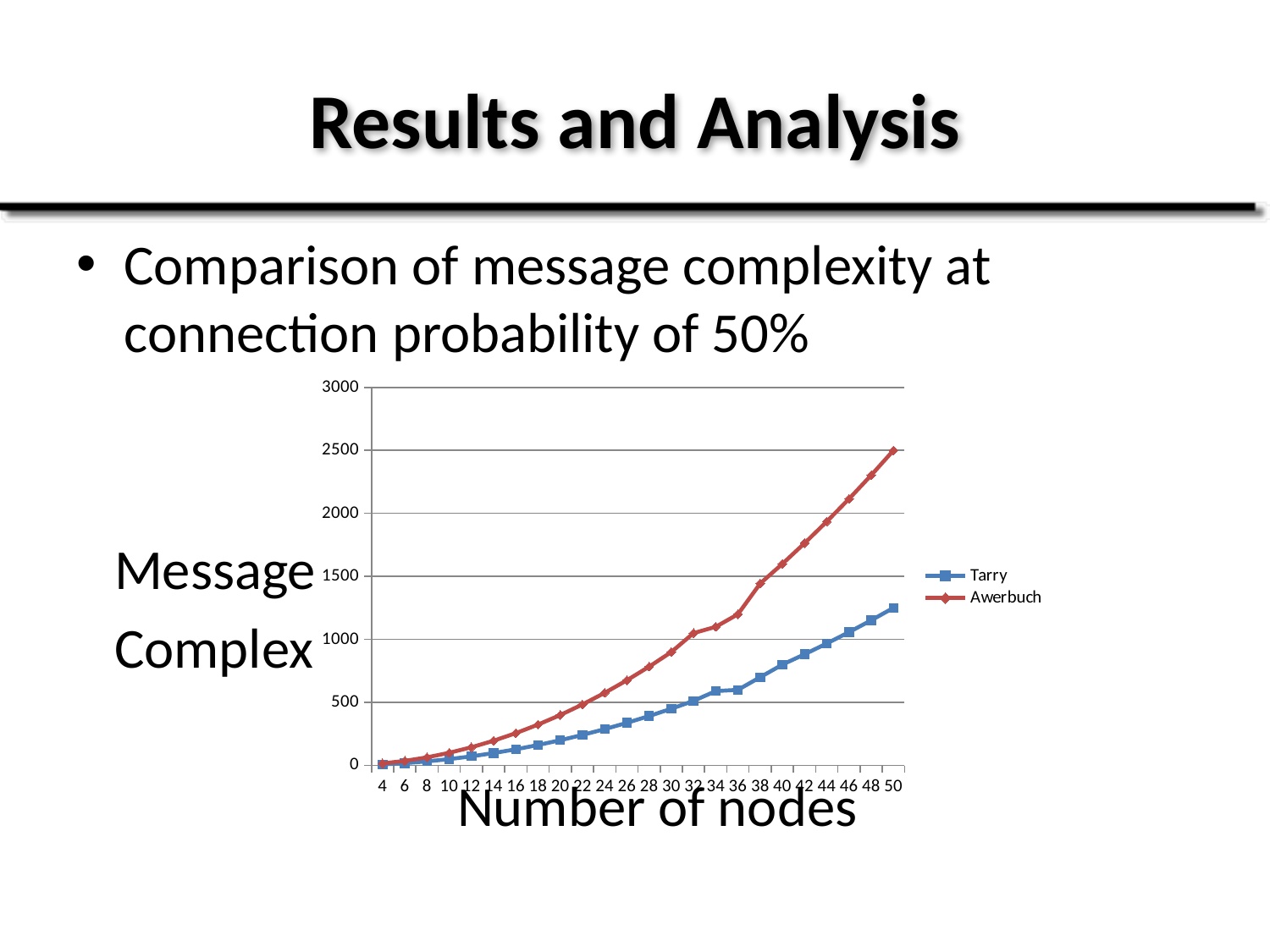
How many points are plotted along the x axis for each series? 24 Do the values for Awerbuch rise or fall as the number of nodes increases? rise Which two series are listed in the legend? Tarry and Awerbuch Is the value for Tarry at 50 nodes greater or less than 1500? less How many series does the legend list? 2 Which series has the higher value at 50 nodes? Awerbuch Which series has the lower value at 40 nodes? Tarry What is the label of the x axis? Number of nodes What kind of chart is shown on the slide? line chart Is the value for Awerbuch at 30 nodes greater or less than 500? greater Is the value for Awerbuch at 40 nodes greater or less than 1500? greater